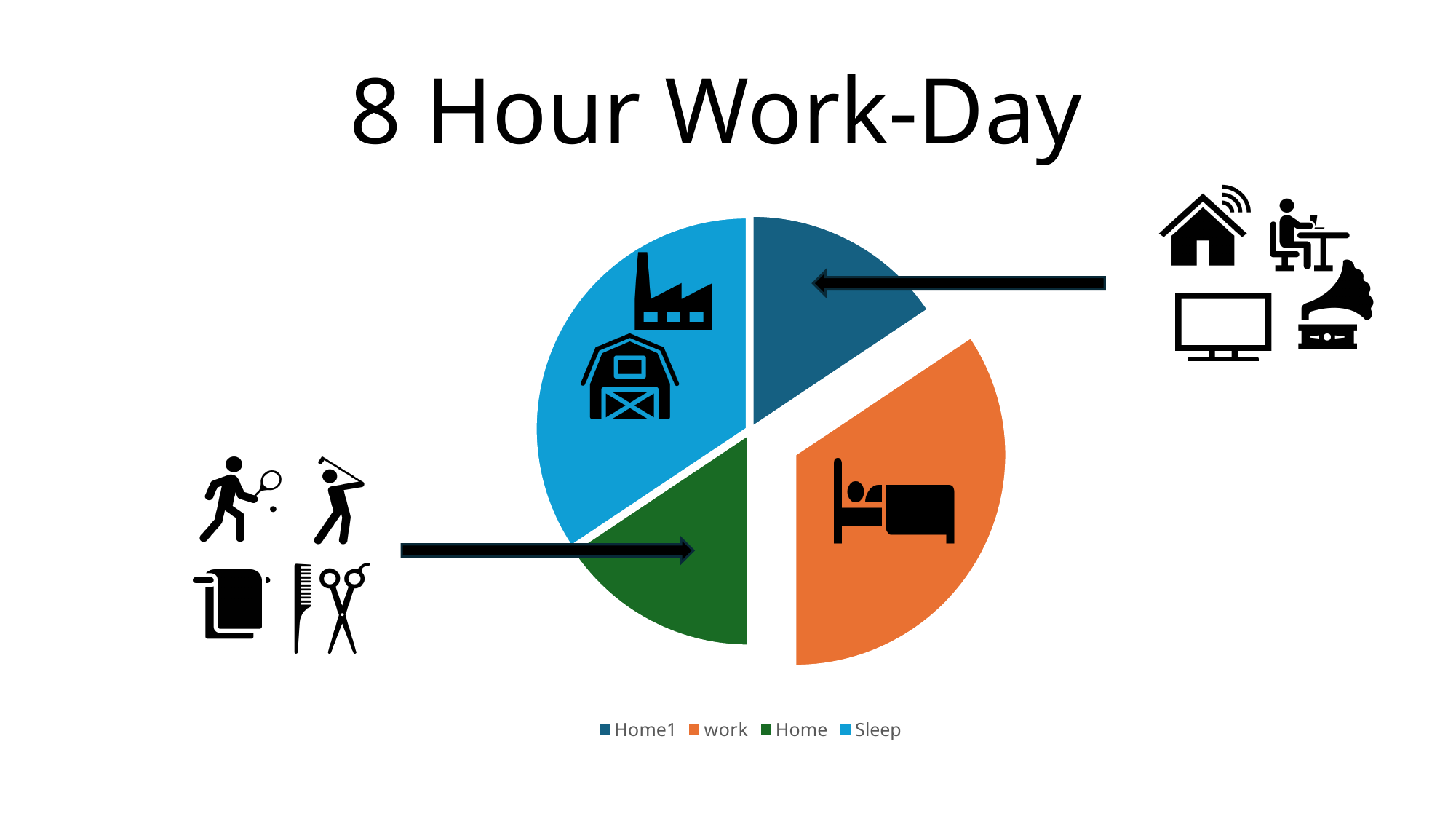
Which legend entry is shown in orange? work Which slice is larger, Sleep or Home1? Sleep What is the title of the slide containing the pie chart? 8 Hour Work-Day What kind of chart is shown on the slide? pie chart How many slices does the pie chart have? 4 How many entries does the chart's legend list? 4 Which slice is larger, Sleep or Home? Sleep Which slice is larger, work or Home1? work